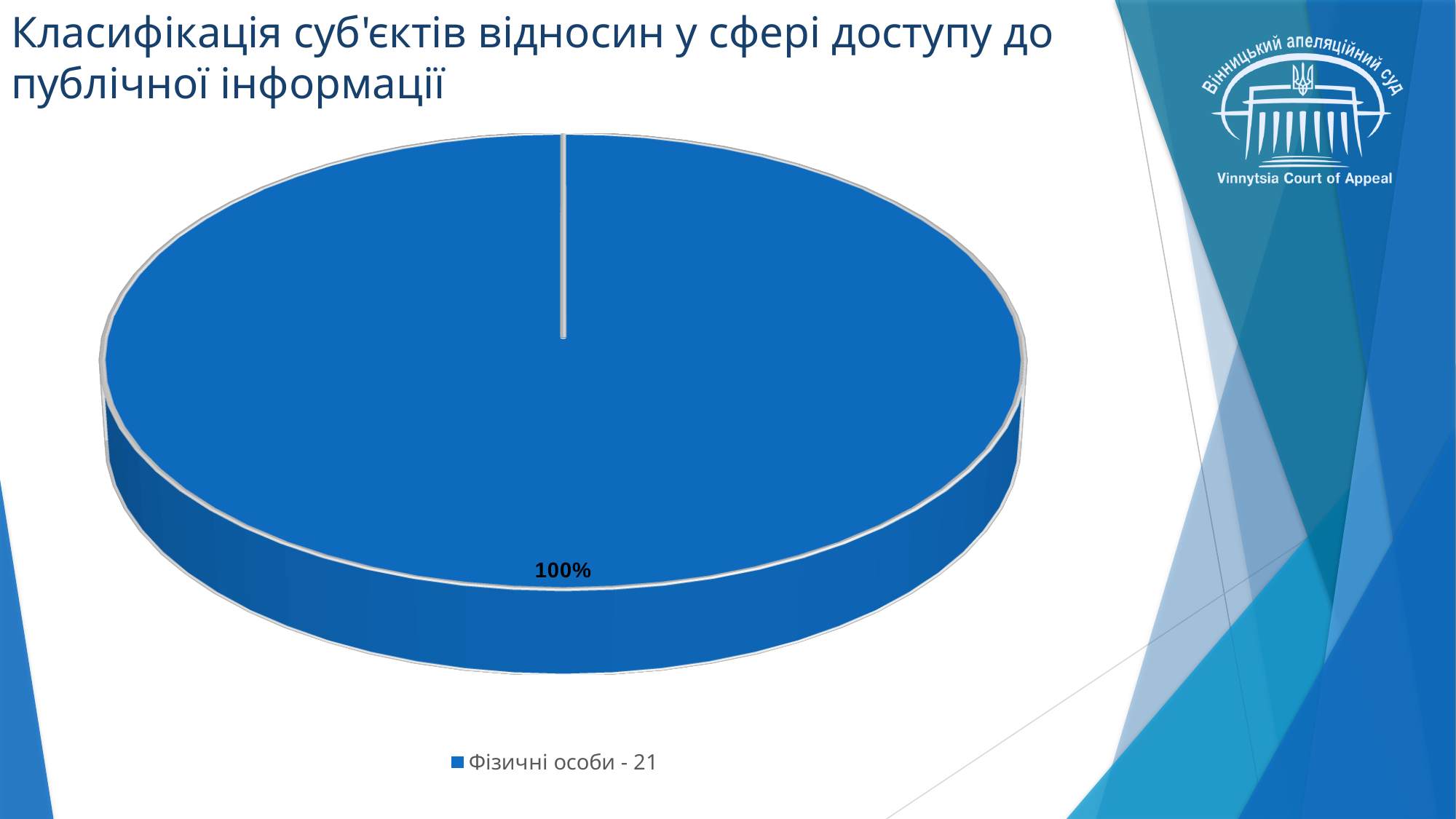
What percentage label is printed on the pie chart? 100% What kind of chart is shown on the slide? pie chart How many slices does the pie chart have? 1 What share of the pie does the slice labelled on the chart represent? 100% How many entries does the legend list? 1 What number is given for Фізичні особи in the legend? 21 What colour is the pie slice? blue What is the legend entry shown below the pie chart? Фізичні особи - 21